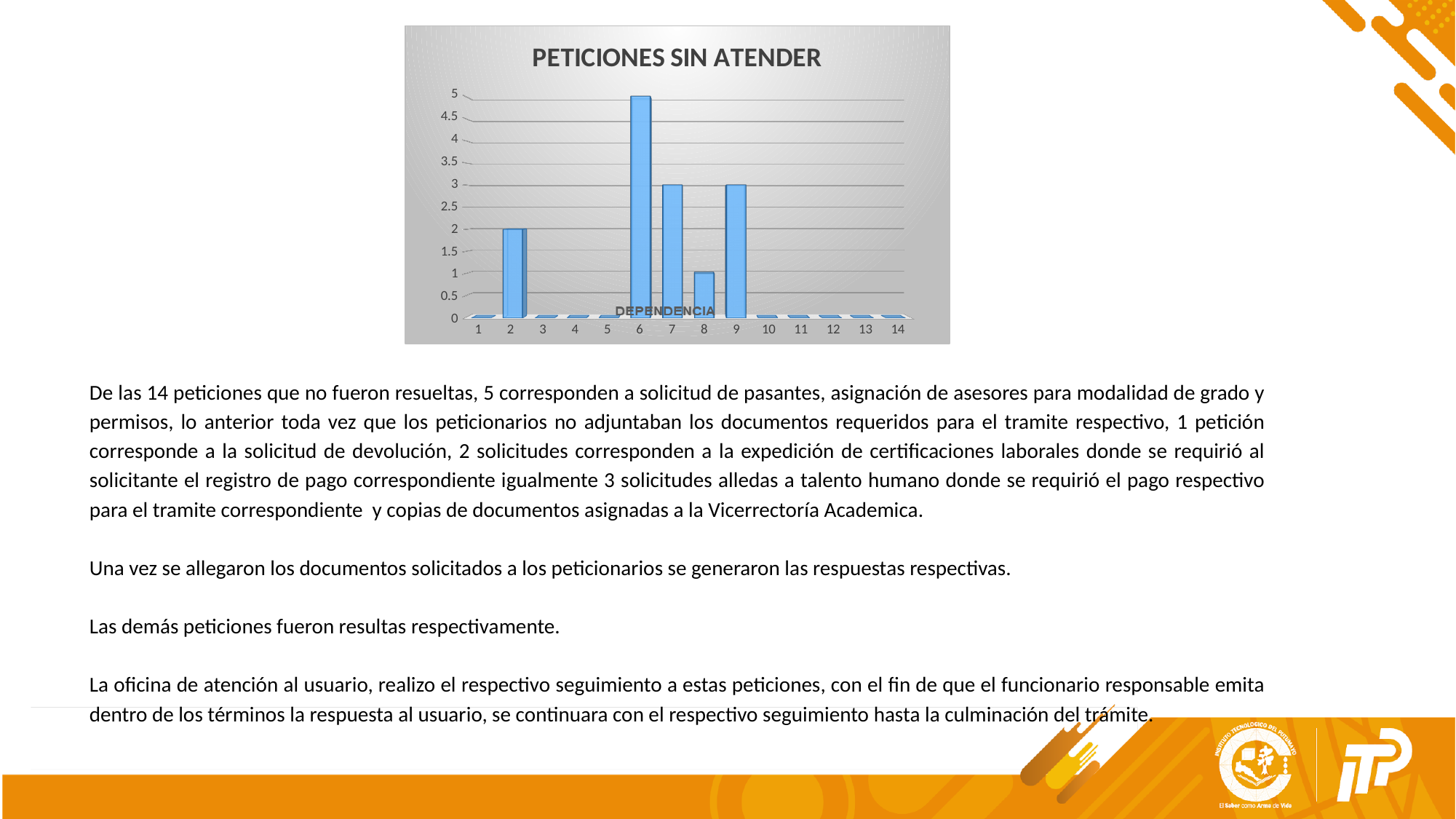
What label appears along the x axis of the chart? DEPENDENCIA Which category has the highest value in the chart? 6 What is the value for category 6? 5 What is the difference between the values for category 6 and category 7? 2 What is the value for category 8? 1 Is the value for category 6 greater or less than 4? greater What is the title of the chart? PETICIONES SIN ATENDER Which is larger, the value for category 2 or the value for category 9? 9 How many categories are shown on the x axis of the chart? 14 What is the value for category 7? 3 What kind of chart is shown on the slide? bar chart What is the value for category 2? 2